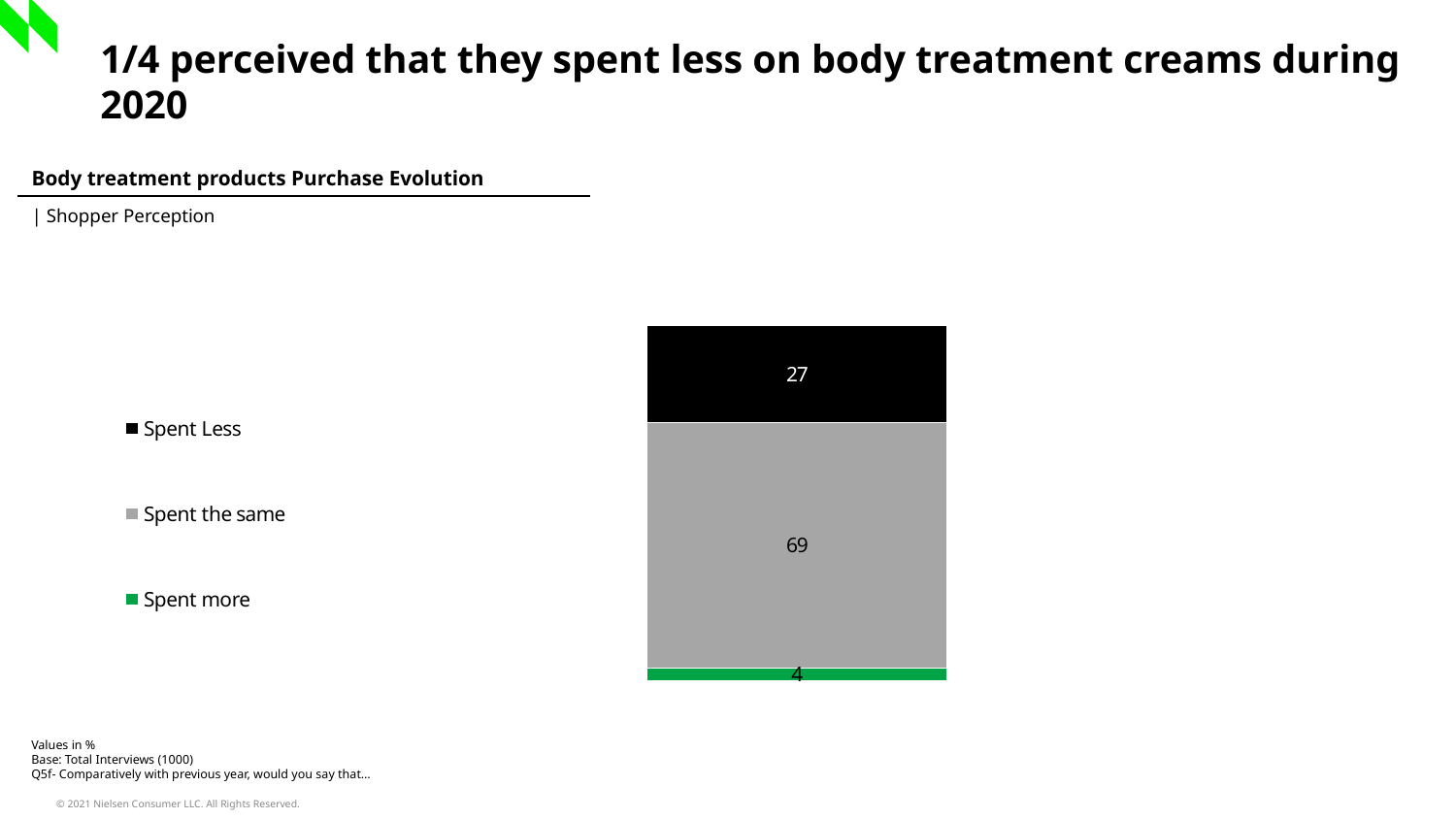
Which is larger, Spent Less or Spent more? Spent Less What value is shown for Spent Less? 27 What is the difference between the Spent Less and Spent more values? 23 What value is shown for Spent the same? 69 Which segment has the highest value? Spent the same What is the total of the stacked bar? 100 Which segment has the lowest value? Spent more What kind of chart is shown? Stacked bar chart How many series does the legend list? 3 What is the difference between the Spent the same and Spent Less values? 42 What value is shown for Spent more? 4 Which colour represents Spent more in the legend? Green